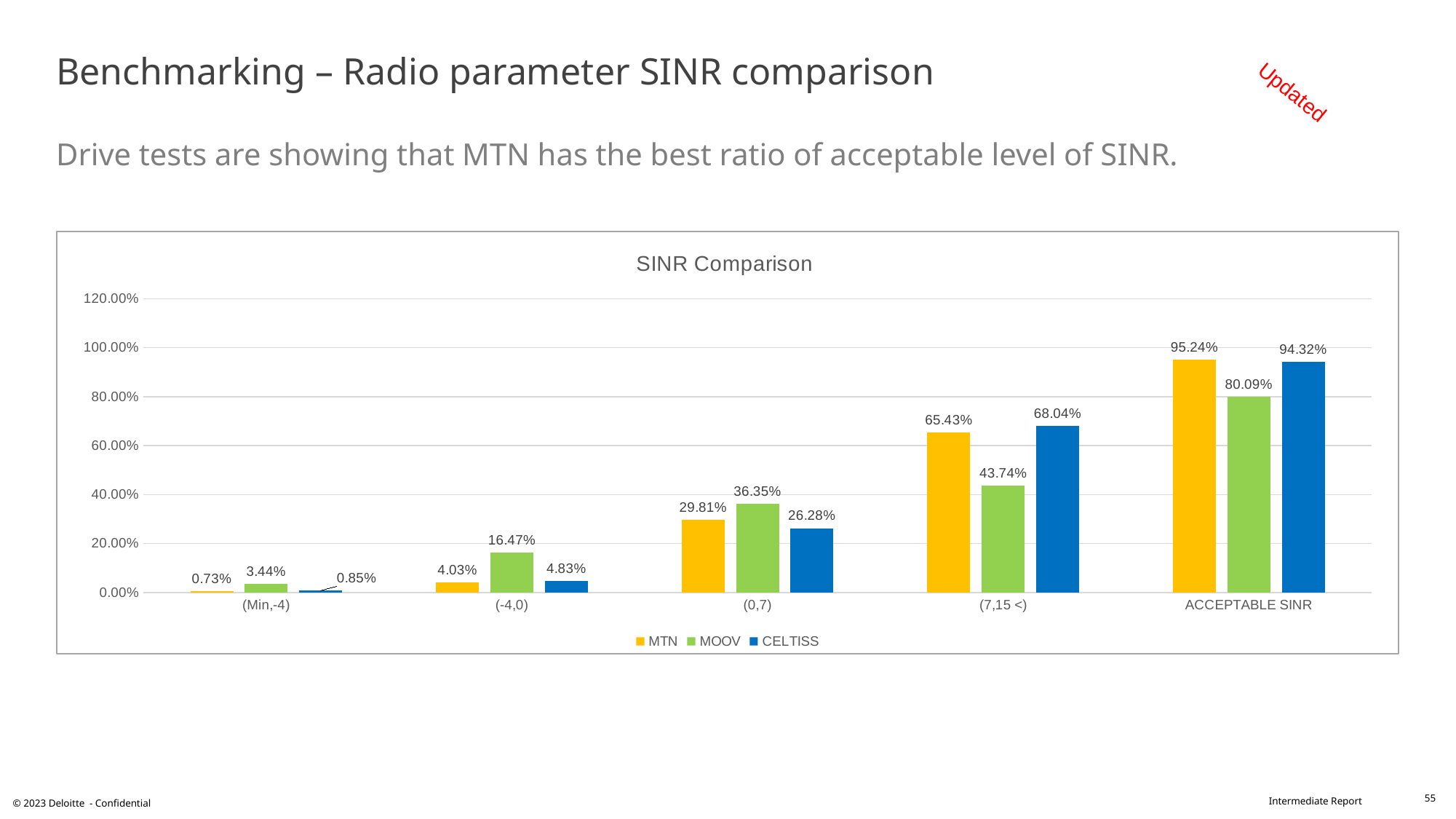
What kind of chart is shown on the slide? Bar chart How many series does the legend list? 3 Which series has the highest value in the (7,15 <) category? CELTISS What is the value for MTN in the ACCEPTABLE SINR category? 95.24% What is the title of the chart? SINR Comparison Do the MTN values rise or fall from (Min,-4) to ACCEPTABLE SINR? Rise What is the value for CELTISS in the (0,7) category? 26.28% What is the difference between MTN and MOOV in the ACCEPTABLE SINR category? 15.15% What is the value for MOOV in the (-4,0) category? 16.47% How many categories are shown on the x axis? 5 Which series has the lowest value in the ACCEPTABLE SINR category? MOOV Which is larger in the (0,7) category, MTN or MOOV? MOOV